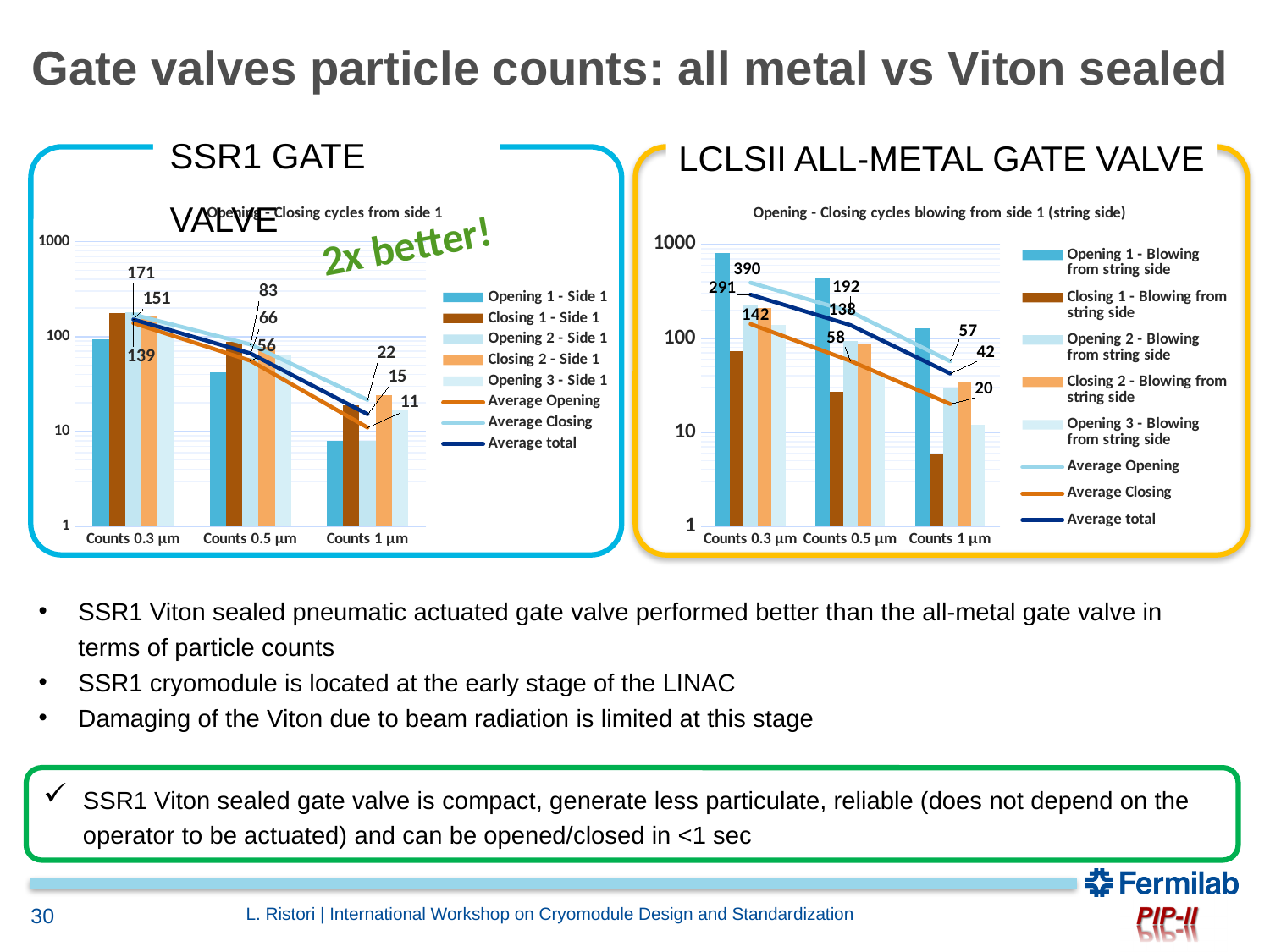
On the left chart, is the Opening 1 - Side 1 value at Counts 1 µm greater or less than 10? less On the right chart, which category has the highest Opening 1 - Blowing from string side bar? Counts 0.3 µm What is the title of the chart on the right? Opening - Closing cycles blowing from side 1 (string side) On the right chart, is the Opening 1 - Blowing from string side value at Counts 0.3 µm greater or less than 100? greater On the right chart at Counts 0.3 µm, which is larger: Opening 1 - Blowing from string side or Closing 1 - Blowing from string side? Opening 1 - Blowing from string side On the right chart, do the particle counts rise or fall from Counts 0.3 µm to Counts 1 µm? fall How many series does the legend of the left chart (Opening - Closing cycles from side 1) list? 8 What kind of chart is the SSR1 gate valve chart on the left? combination bar and line chart On the right chart, is the Closing 1 - Blowing from string side value at Counts 1 µm greater or less than 10? less How many categories are shown on the x axis of the LCLSII all-metal gate valve chart on the right? 3 How many series does the legend of the right chart (Opening - Closing cycles blowing from side 1) list? 8